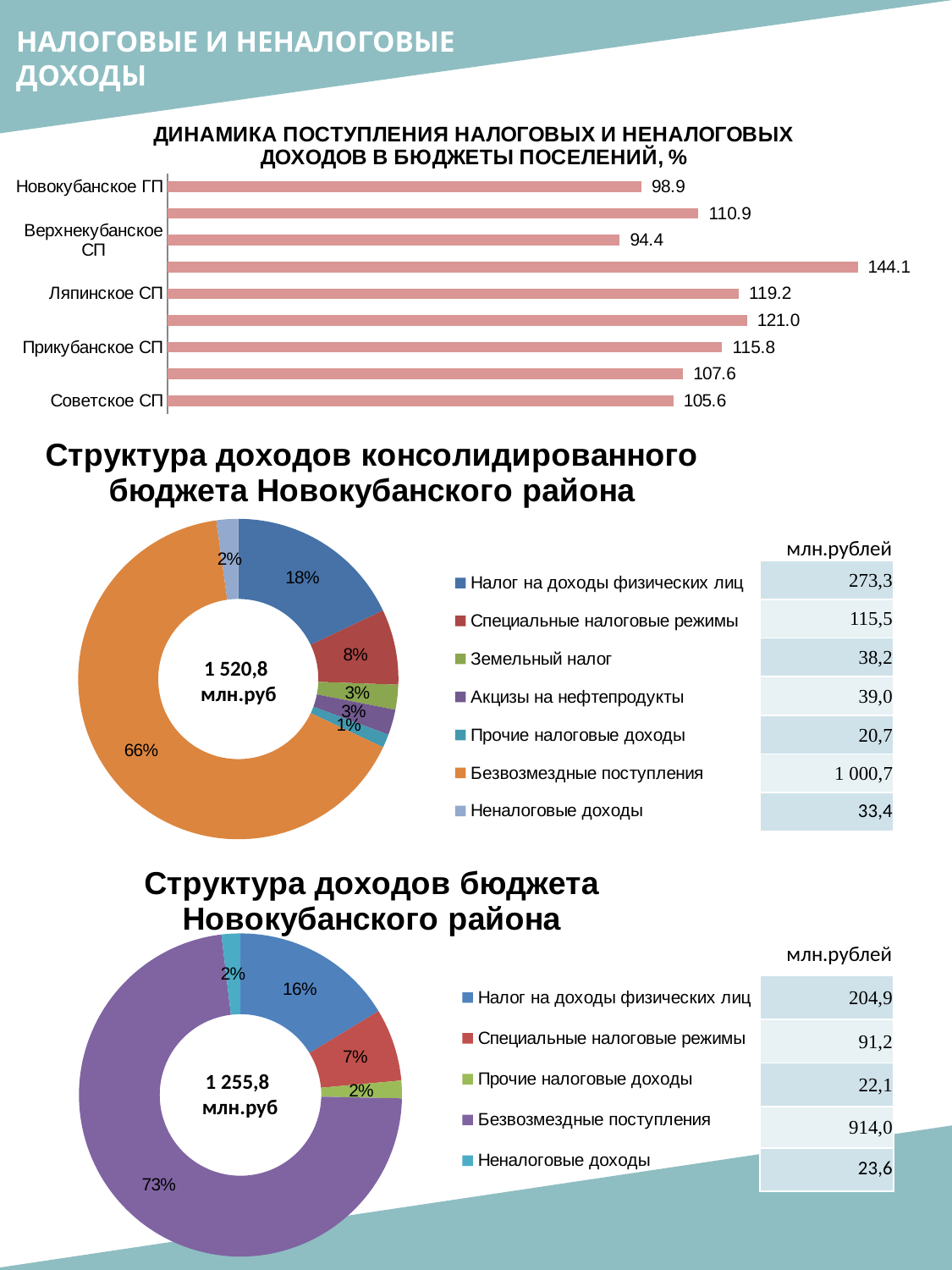
In the chart 'Структура доходов бюджета Новокубанского района', what is the total shown in the centre of the donut? 1 255,8 млн.руб In the top bar chart, what is the value for Советское СП? 105.6 In the chart 'Структура доходов консолидированного бюджета Новокубанского района', what is the value in млн.рублей for Налог на доходы физических лиц? 273,3 In the top bar chart, what is the value for Ляпинское СП? 119.2 What type of chart is the top chart titled 'ДИНАМИКА ПОСТУПЛЕНИЯ НАЛОГОВЫХ И НЕНАЛОГОВЫХ ДОХОДОВ В БЮДЖЕТЫ ПОСЕЛЕНИЙ, %'? bar chart In the top bar chart, which of the labelled settlements has the lowest value? Верхнекубанское СП In the top bar chart, what is the highest value shown on any bar? 144.1 In the top bar chart, which is larger: the value for Прикубанское СП or the value for Советское СП? Прикубанское СП In the top bar chart, what is the value for Новокубанское ГП? 98.9 In the chart 'Структура доходов консолидированного бюджета Новокубанского района', what share does Безвозмездные поступления have? 66% How many categories does the legend list for the chart 'Структура доходов бюджета Новокубанского района'? 5 In the top bar chart, how many bars are plotted? 9